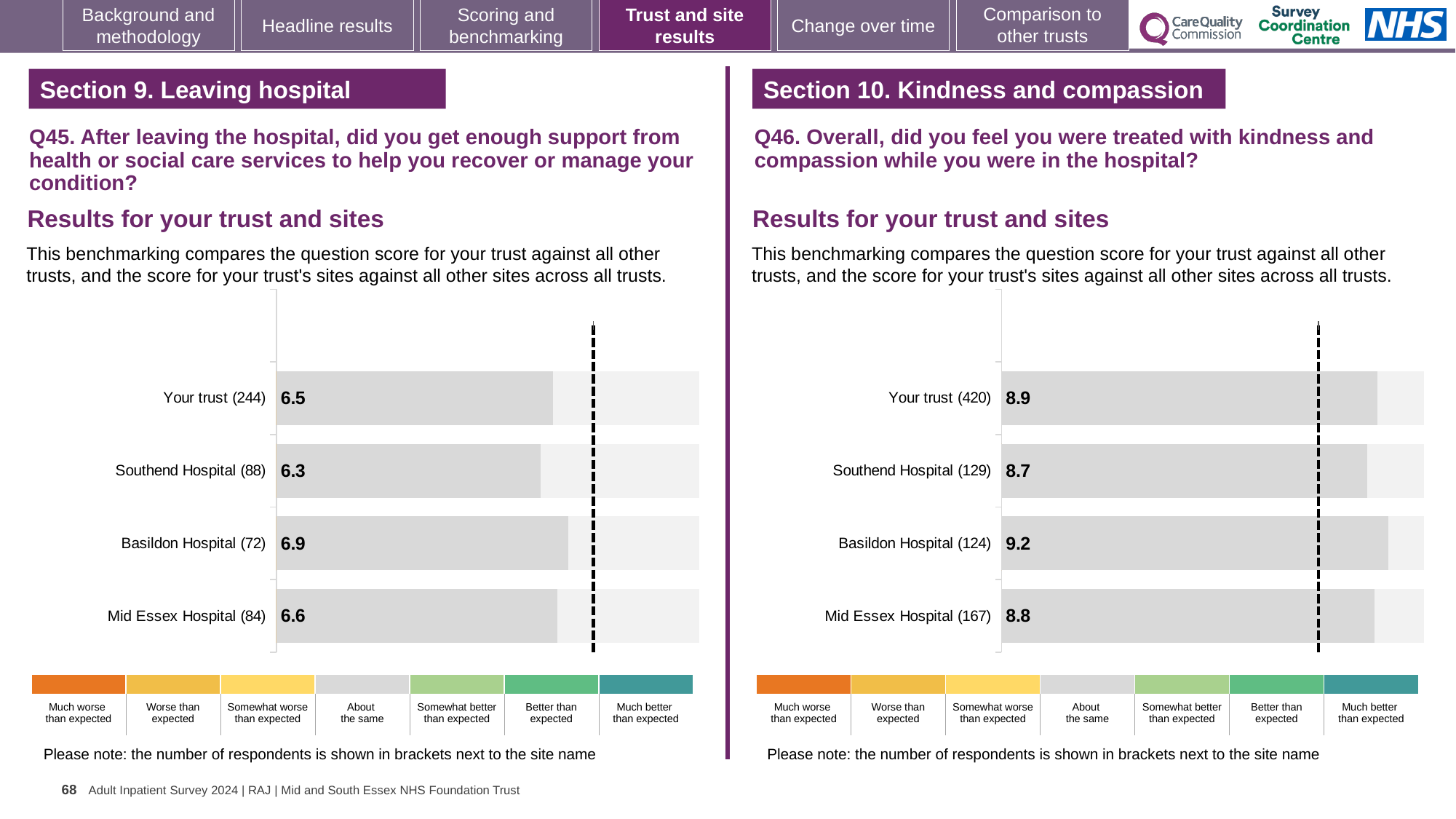
In the Q45 chart (left), what is the score for Basildon Hospital? 6.9 In the Q46 chart (right), which site has the highest score? Basildon Hospital In the Q46 chart (right), what is the difference between the scores for Basildon Hospital and Your trust? 0.3 In the Q45 chart (left), which site has the lowest score? Southend Hospital In the Q45 chart (left), how many bars are plotted? 4 In the Q45 chart (left), what is the difference between the scores for Basildon Hospital and Southend Hospital? 0.6 In the Q46 chart (right), what is the score for Southend Hospital? 8.7 What kind of chart is used for the Q45 results on the left? Bar chart In the Q45 chart (left), what is the score for Your trust? 6.5 In the Q46 chart (right), which has the larger score, Your trust or Southend Hospital? Your trust In the Q46 chart (right), how many respondents are shown in brackets for Your trust? 420 In the Q46 chart (right), what is the score for Mid Essex Hospital? 8.8